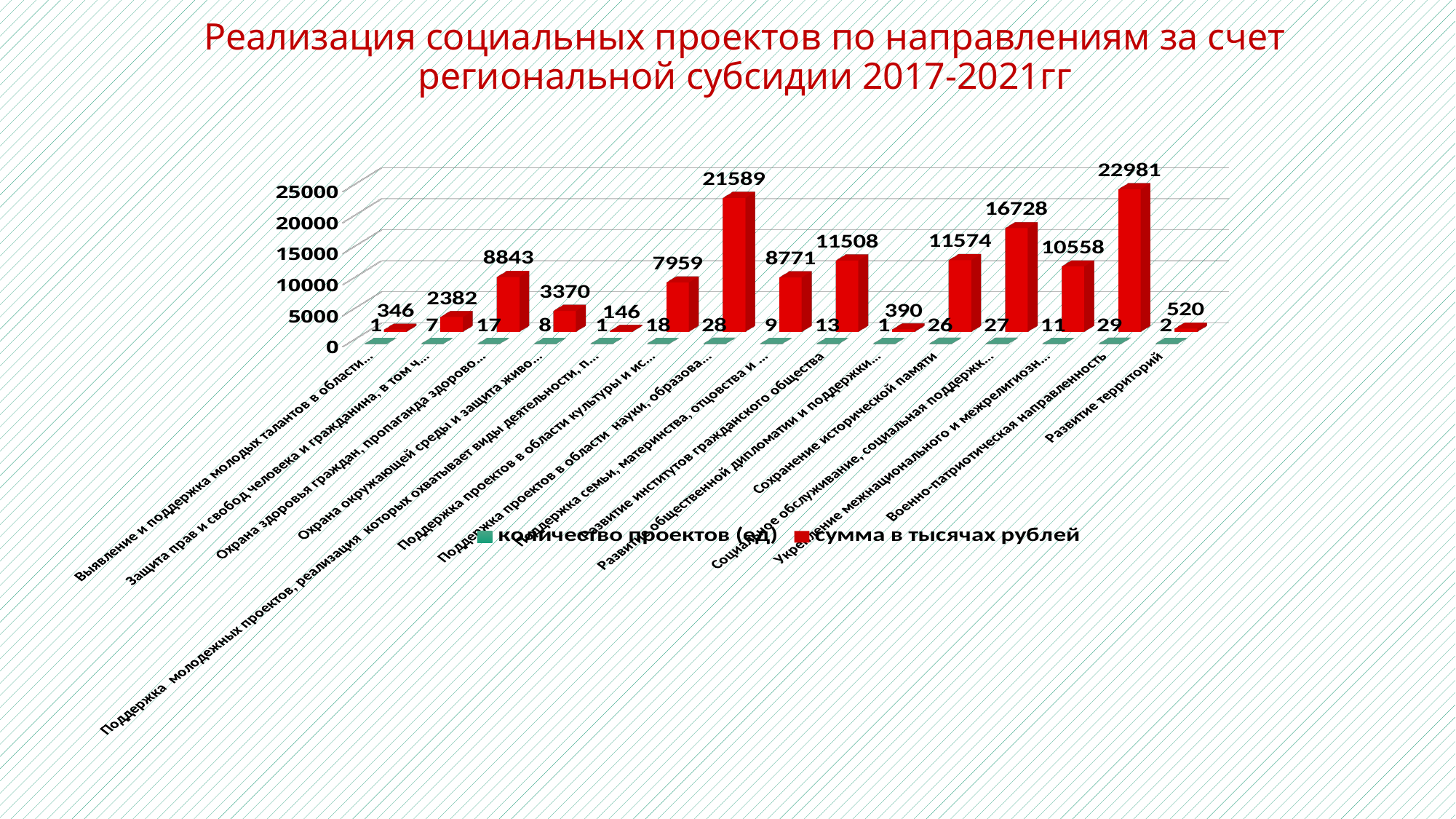
What is the value of 'сумма в тысячах рублей' for 'Развитие институтов гражданского общества'? 11508 Which category has the highest value of 'сумма в тысячах рублей'? Военно-патриотическая направленность What is the value of 'сумма в тысячах рублей' for 'Военно-патриотическая направленность'? 22981 Which category has the highest value of 'количество проектов (ед.)'? Военно-патриотическая направленность Which has the larger 'сумма в тысячах рублей': 'Развитие институтов гражданского общества' or 'Развитие территорий'? Развитие институтов гражданского общества What is the value of 'количество проектов (ед.)' for 'Сохранение исторической памяти'? 26 What is the title of the chart on the slide? Реализация социальных проектов по направлениям за счет региональной субсидии 2017-2021гг What kind of chart is shown on the slide? bar chart What is the difference in 'сумма в тысячах рублей' between 'Военно-патриотическая направленность' and 'Сохранение исторической памяти'? 11407 How many categories are plotted on the chart? 15 How many series does the legend list? 2 What is the value of 'количество проектов (ед.)' for 'Развитие территорий'? 2